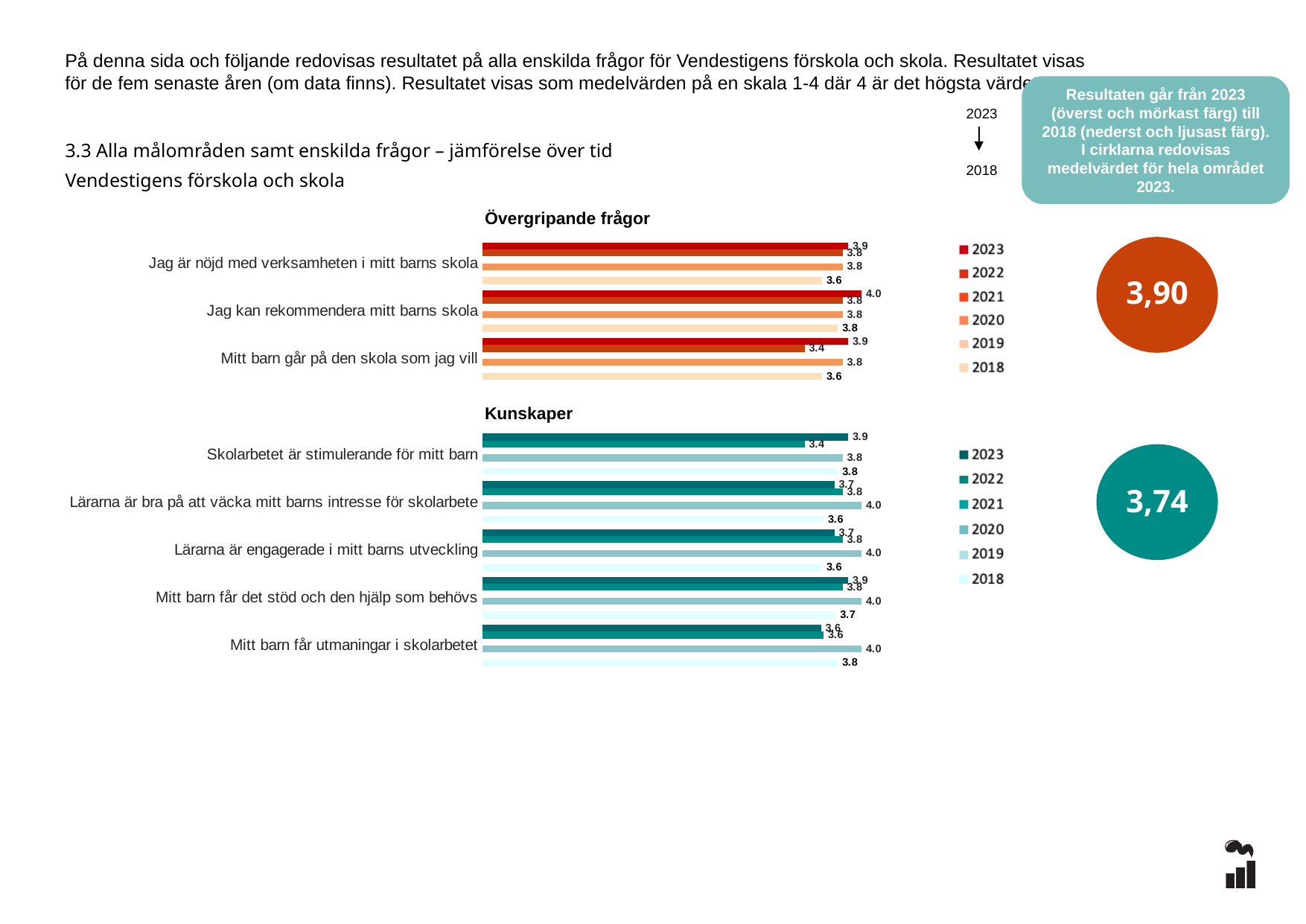
How many years does the legend of the 'Övergripande frågor' chart list? 6 How many questions (categories) are shown in the 'Övergripande frågor' chart? 3 In the 'Kunskaper' chart, what is the difference between the 2023 value for 'Skolarbetet är stimulerande för mitt barn' (3.9) and for 'Mitt barn får utmaningar i skolarbetet' (3.6)? 0.3 How many questions (categories) are shown in the 'Kunskaper' chart? 5 In the 'Kunskaper' chart, what is the 2023 value (top, darkest bar) for 'Mitt barn får utmaningar i skolarbetet'? 3.6 In the 'Övergripande frågor' chart, which question has the highest 2023 value? Jag kan rekommendera mitt barns skola In the 'Kunskaper' chart, which is larger: the 2023 value for 'Mitt barn får det stöd och den hjälp som behövs' or for 'Lärarna är engagerade i mitt barns utveckling'? Mitt barn får det stöd och den hjälp som behövs What is the overall 2023 mean value shown in the circle next to the 'Kunskaper' chart? 3,74 In the 'Kunskaper' chart, which question has the lowest 2023 value? Mitt barn får utmaningar i skolarbetet In the 'Övergripande frågor' chart, what is the 2023 value (top, darkest bar) for 'Jag kan rekommendera mitt barns skola'? 4.0 In the 'Kunskaper' chart, what is the 2023 value (top, darkest bar) for 'Skolarbetet är stimulerande för mitt barn'? 3.9 In the 'Övergripande frågor' chart, what is the 2023 value (top, darkest bar) for 'Jag är nöjd med verksamheten i mitt barns skola'? 3.9